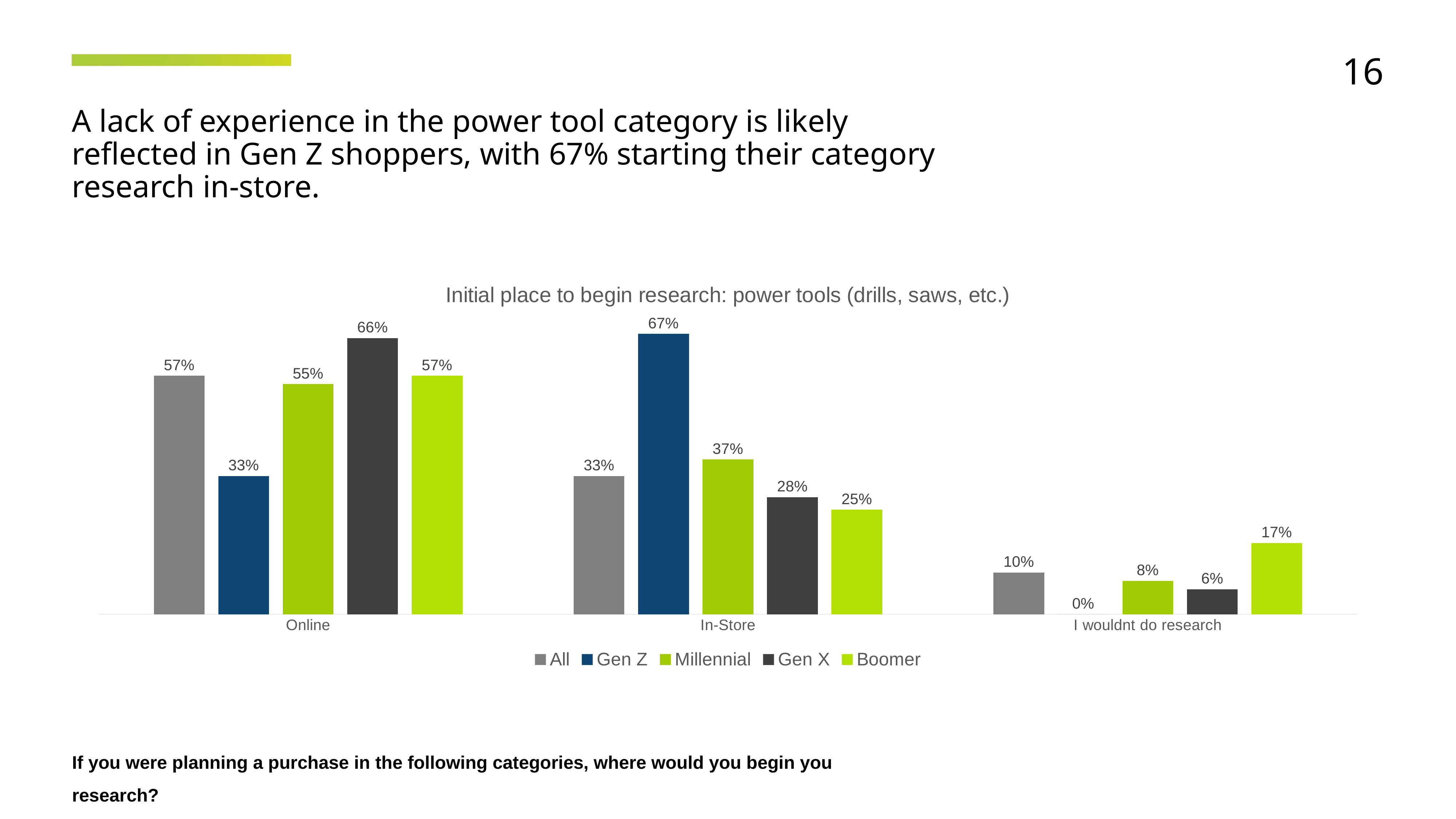
How many series does the legend list? 5 Which series has the lowest value in the Online category? Gen Z What is the value for Gen Z in the 'I wouldnt do research' category? 0% Which is larger in the Online category: the Millennial value or the Gen X value? Gen X What is the value for Gen X in the Online category? 66% What is the value for Boomer in the 'I wouldnt do research' category? 17% Which series has the highest value in the In-Store category? Gen Z What is the title of the chart? Initial place to begin research: power tools (drills, saws, etc.) What is the difference between the Gen Z and All values in the In-Store category? 34% How many categories are shown on the x axis? 3 What is the value for Gen Z in the In-Store category? 67% What kind of chart is shown on the slide? Bar chart